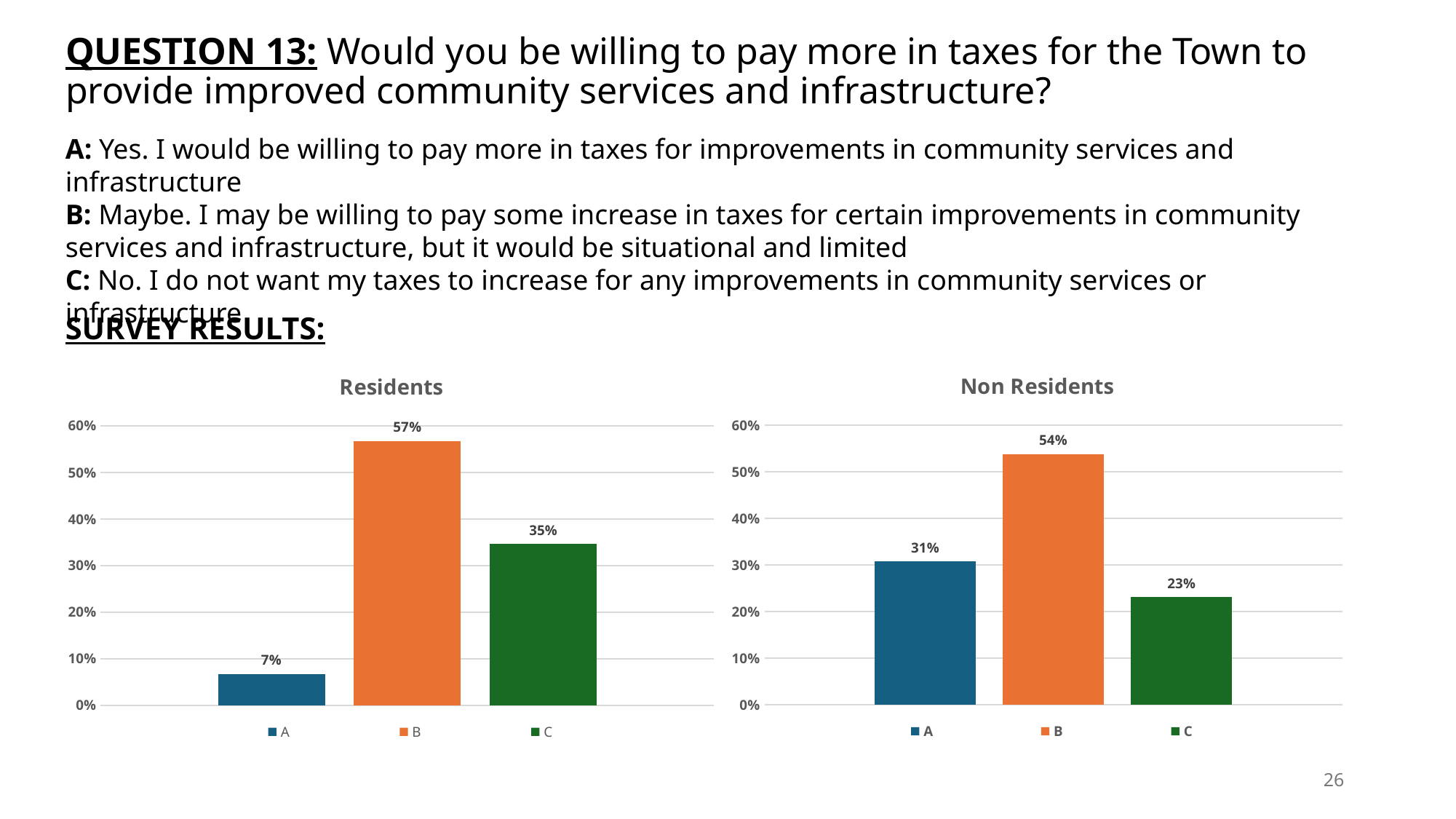
Which is larger: the value for A in the Residents chart or the value for A in the Non Residents chart? Non Residents In the Non Residents chart, what is the value for A? 31% In the Residents chart, what is the value for C? 35% What kind of chart is the Non Residents chart? bar chart In the Non Residents chart, is the value for C greater or less than 30%? less In the Residents chart, what is the value for B? 57% In the Non Residents chart, what is the difference between the values for A and C? 8% How many categories are shown in the Residents chart? 3 In the Non Residents chart, which category has the highest value? B What colour is the bar for B in the Residents chart? orange In the Residents chart, what is the difference between the values for B and C? 22% In the Residents chart, which category has the lowest value? A